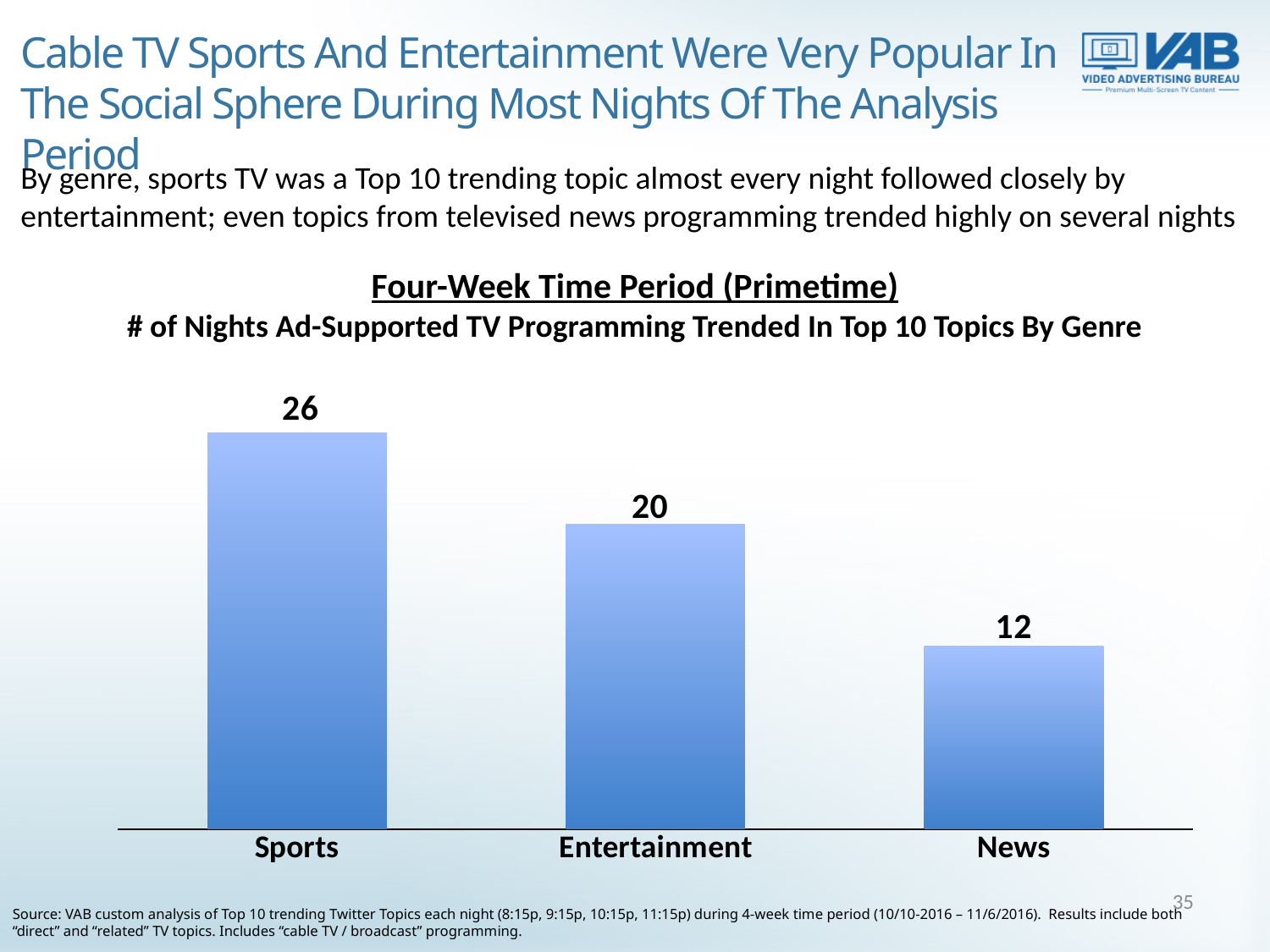
How many genres are shown in the chart? 3 Do the values rise or fall moving from Sports to News along the x axis? Fall How many nights did Sports programming trend in the Top 10 topics? 26 Which genre trended in the Top 10 topics on the most nights? Sports What type of chart is shown on the slide? Bar chart What is the underlined title above the chart? Four-Week Time Period (Primetime) Which genre has the higher value, Entertainment or News? Entertainment What is the difference in number of nights between Sports and Entertainment? 6 How many nights did Entertainment programming trend in the Top 10 topics? 20 How many nights did News programming trend in the Top 10 topics? 12 Which genre trended in the Top 10 topics on the fewest nights? News What is the difference in number of nights between Entertainment and News? 8